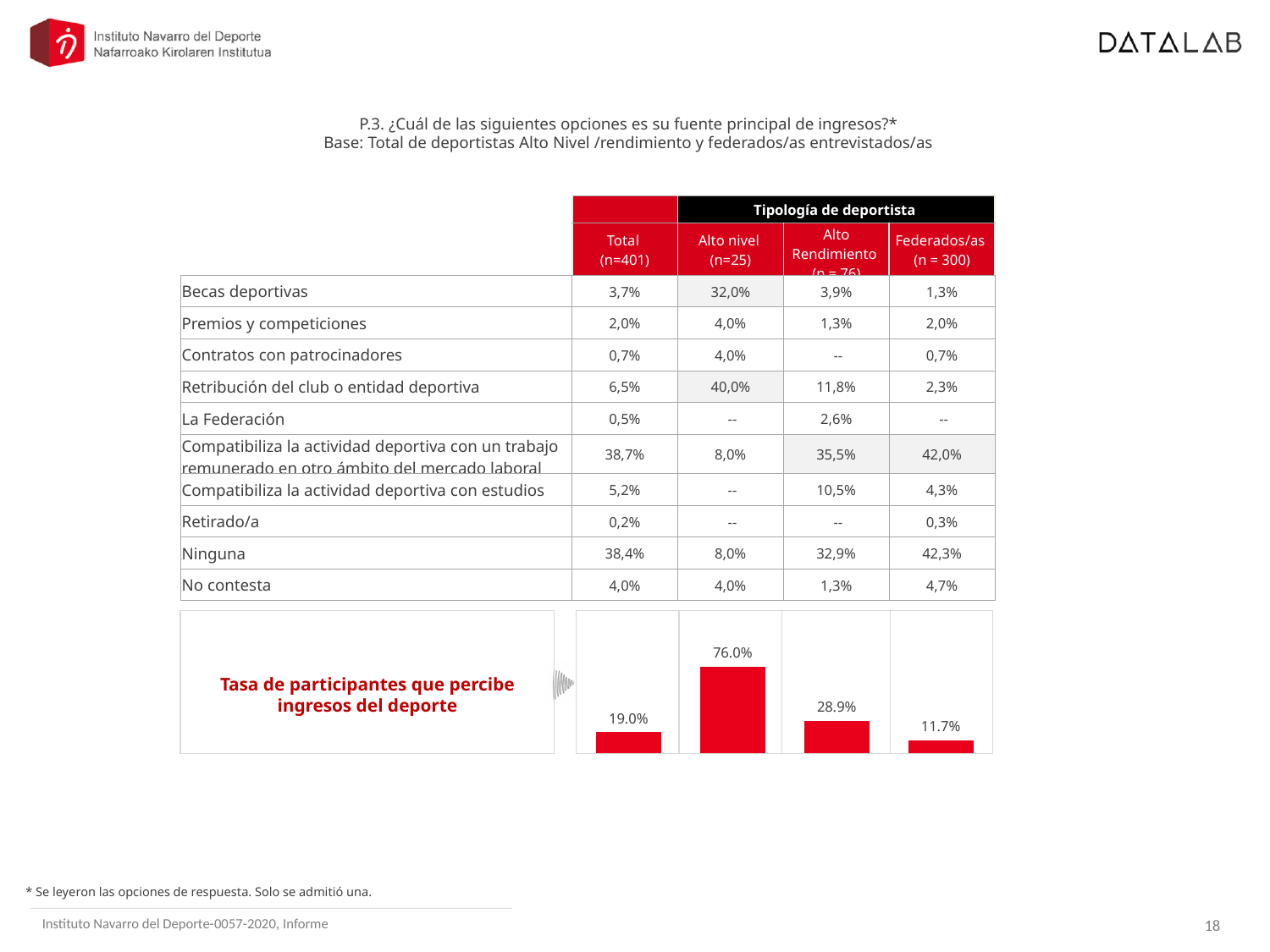
In the chart 'Tasa de participantes que percibe ingresos del deporte', what is the value for the Alto nivel group? 76.0% In the chart 'Tasa de participantes que percibe ingresos del deporte', what is the value for the Alto Rendimiento group? 28.9% What colour are the bars in the chart 'Tasa de participantes que percibe ingresos del deporte'? Red In the chart 'Tasa de participantes que percibe ingresos del deporte', what is the value for the Federados/as group? 11.7% In the chart 'Tasa de participantes que percibe ingresos del deporte', what is the value for the Total column? 19.0% In the chart 'Tasa de participantes que percibe ingresos del deporte', which is larger, the Alto Rendimiento value or the Total value? Alto Rendimiento In the chart 'Tasa de participantes que percibe ingresos del deporte', what is the difference between the Total value and the Federados/as value? 7.3 percentage points How many bars are shown in the chart 'Tasa de participantes que percibe ingresos del deporte'? 4 What type of chart is 'Tasa de participantes que percibe ingresos del deporte'? Bar chart In the chart 'Tasa de participantes que percibe ingresos del deporte', what is the difference between the Alto nivel value and the Alto Rendimiento value? 47.1 percentage points In the chart 'Tasa de participantes que percibe ingresos del deporte', which group has the highest rate? Alto nivel In the chart 'Tasa de participantes que percibe ingresos del deporte', which group has the lowest rate? Federados/as